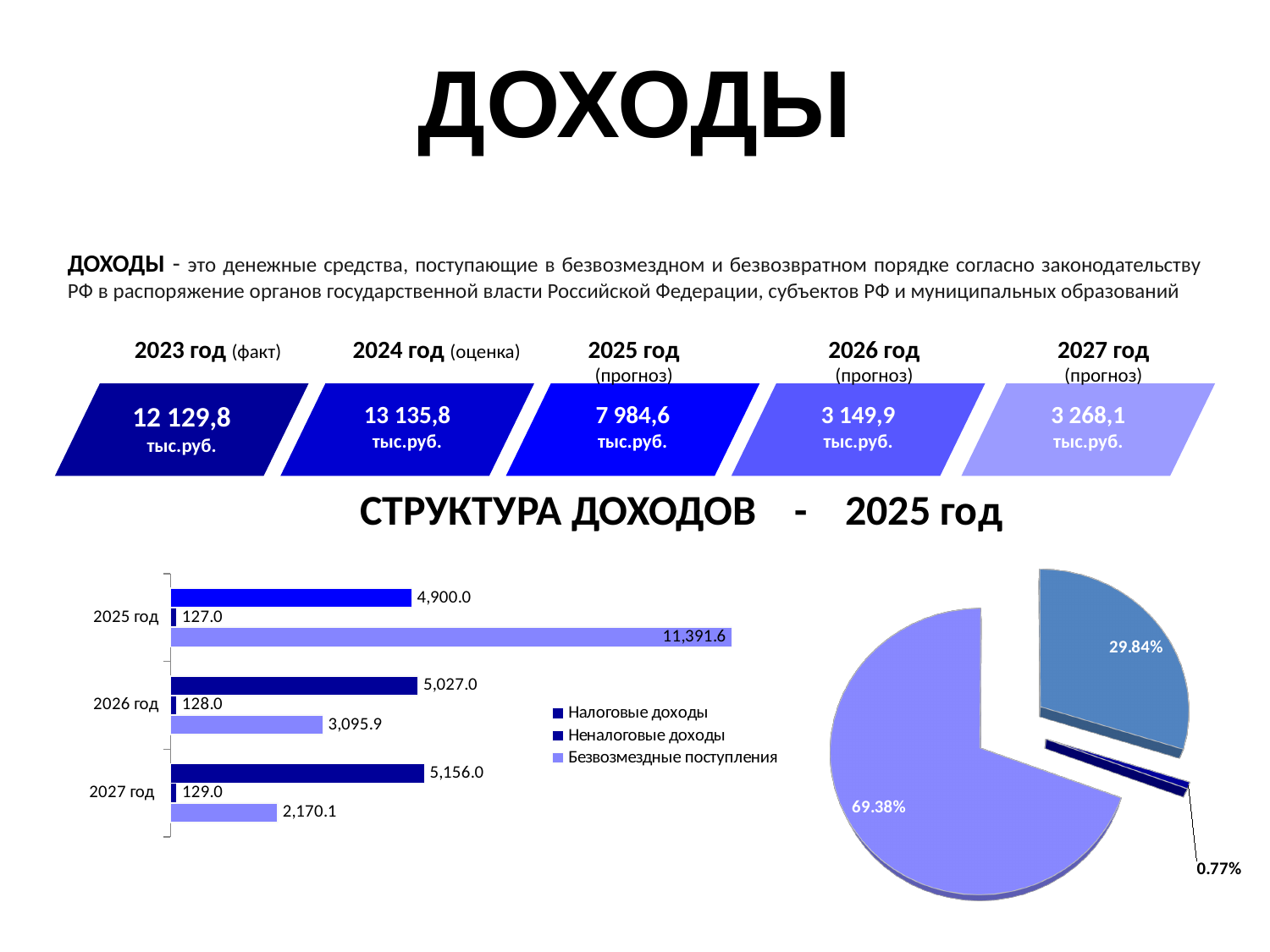
In the pie chart on the right, what is the share of the largest slice? 69.38% In the bar chart on the left, how many series does the legend list? 3 In the bar chart on the left, which year has the highest value for Безвозмездные поступления? 2025 год In the bar chart on the left, how many years are shown on the axis? 3 In the bar chart on the left, which year has the lowest value for Налоговые доходы? 2025 год In the bar chart on the left, which is larger in 2026 год: Налоговые доходы or Безвозмездные поступления? Налоговые доходы In the bar chart on the left, what is the value for Безвозмездные поступления in 2027 год? 2,170.1 In the bar chart on the left, what is the difference between Налоговые доходы in 2027 год and in 2025 год? 256.0 In the bar chart on the left, do the values for Безвозмездные поступления rise or fall from 2025 год to 2027 год? fall In the bar chart on the left, what is the value for Неналоговые доходы in 2026 год? 128.0 In the bar chart on the left, what is the value for Налоговые доходы in 2025 год? 4,900.0 What type of chart is shown on the left of the slide? bar chart